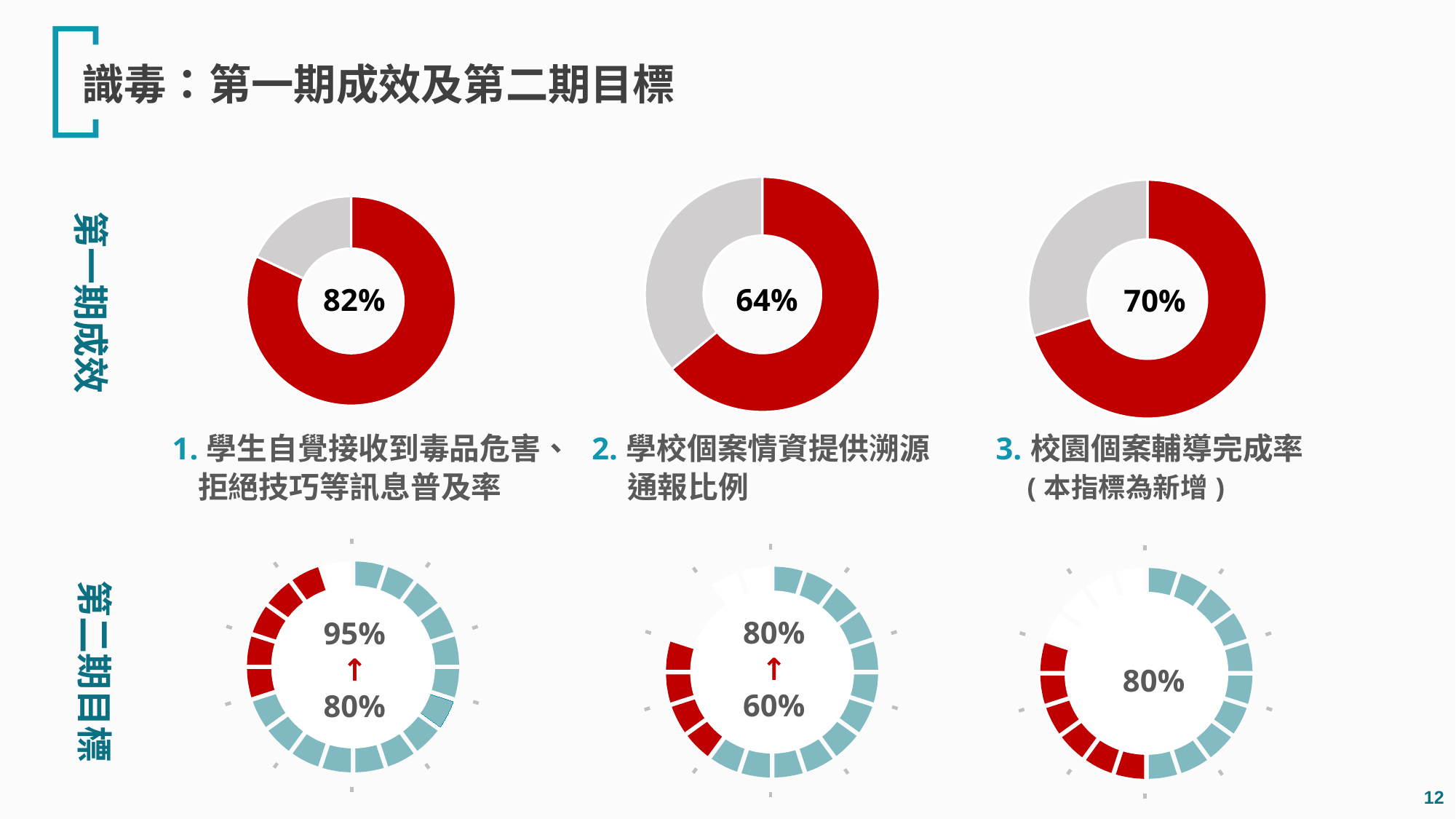
In the bottom row (第二期目標), what target value is shown in the second chart (indicator 2), and from what previous value? 80%, up from 60% How many donut charts are shown in the top row (第一期成效)? 3 In the top row (第一期成效), what value is shown in the centre of the first donut chart (indicator 1, 學生自覺接收到毒品危害、拒絕技巧等訊息普及率)? 82% In the bottom row (第二期目標), what target value is shown in the first chart (indicator 1), and from what previous value? 95%, up from 80% What type of chart is used in the top row (第一期成效) to show the values 82%, 64% and 70%? Donut (pie) chart In the bottom row (第二期目標), what target value is shown in the third chart (indicator 3)? 80% In the top row (第一期成效), what value is shown in the centre of the second donut chart (indicator 2, 學校個案情資提供溯源通報比例)? 64% In the top row (第一期成效), what value is shown in the centre of the third donut chart (indicator 3, 校園個案輔導完成率)? 70% Among the three donut charts in the top row (第一期成效), which indicator has the lowest value? Indicator 2 (學校個案情資提供溯源通報比例), 64% In the top row (第一期成效), which is larger: the value of the second donut chart (indicator 2) or the third donut chart (indicator 3)? The third donut chart (indicator 3), 70% Among the three donut charts in the top row (第一期成效), which indicator has the highest value? Indicator 1 (學生自覺接收到毒品危害、拒絕技巧等訊息普及率), 82% In the top row (第一期成效), what is the difference between the value of the first donut chart (82%) and the second donut chart (64%)? 18%